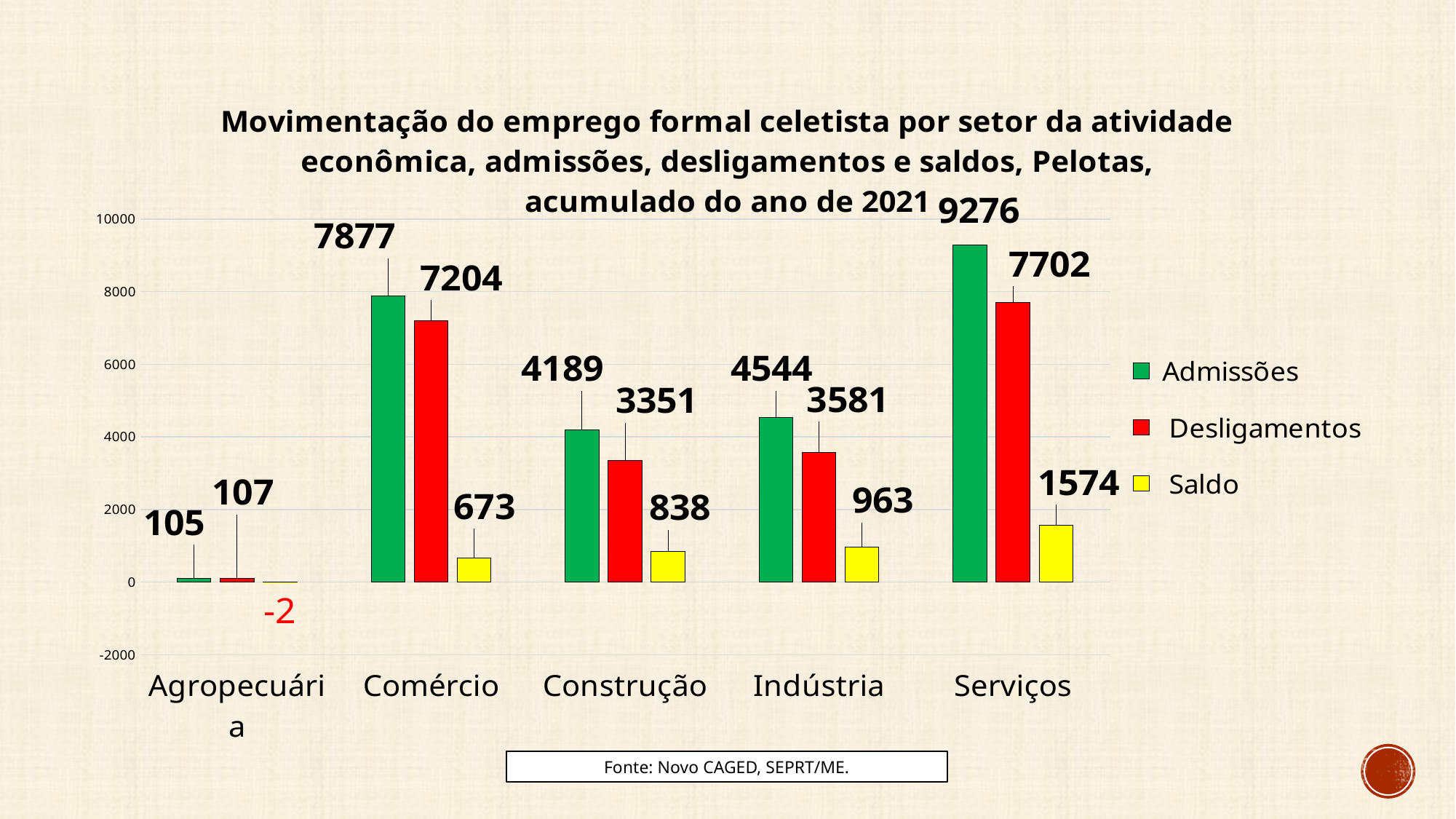
Is the Desligamentos value for Serviços greater or less than 8000? less How many sectors (categories) are shown on the x axis? 5 Which sector has the lowest Saldo value? Agropecuária Which sector has the highest Admissões value? Serviços What is the value of Admissões for Serviços? 9276 What is the difference between Admissões and Desligamentos for Indústria? 963 What type of chart is shown on the slide? bar chart What colour are the Saldo bars? yellow Which is larger, the Saldo for Construção or the Saldo for Indústria? Indústria What is the value of Desligamentos for Comércio? 7204 What is the Saldo for Agropecuária? -2 How many series does the legend list? 3